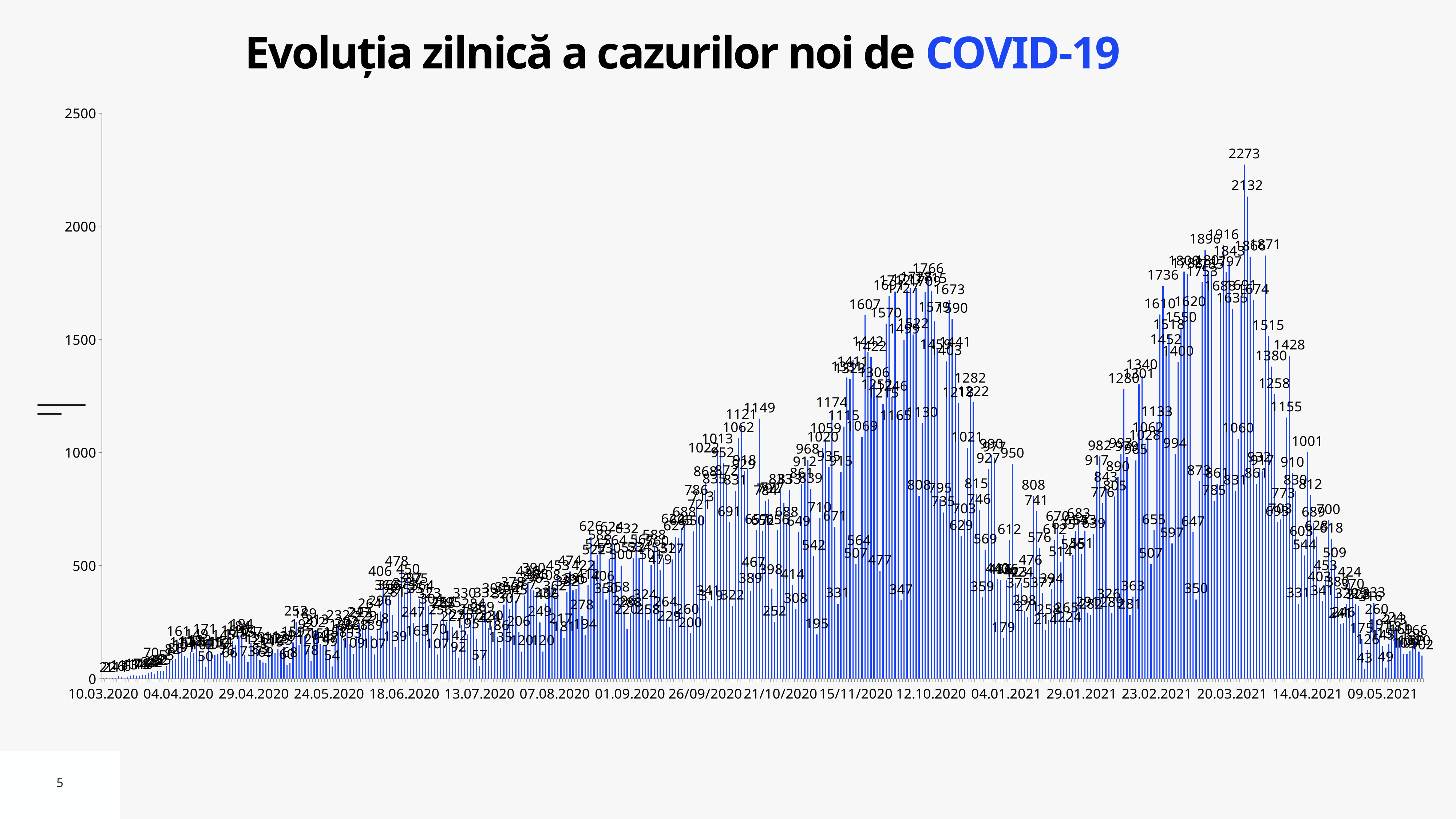
Do the values rise or fall between 23.02.2021 and 20.03.2021? rise What is the last date label shown on the horizontal axis? 09.05.2021 What is the highest daily value labelled on the chart? 2273 Do the values rise or fall between 14.04.2021 and 09.05.2021? fall Is the highest bar on the chart greater or less than 2000? greater What is the difference between the two highest labelled values, 2273 and 2132? 141 What is the highest tick value shown on the vertical axis? 2500 What is the title of the chart? Evoluția zilnică a cazurilor noi de COVID-19 What is the second highest daily value labelled on the chart, next to the 2273 peak? 2132 What kind of chart is shown on the slide? bar chart Is the value for the first date, 10.03.2020, greater or less than 500? less Which is larger, the peak value of 2273 or the neighbouring value of 2132? 2273